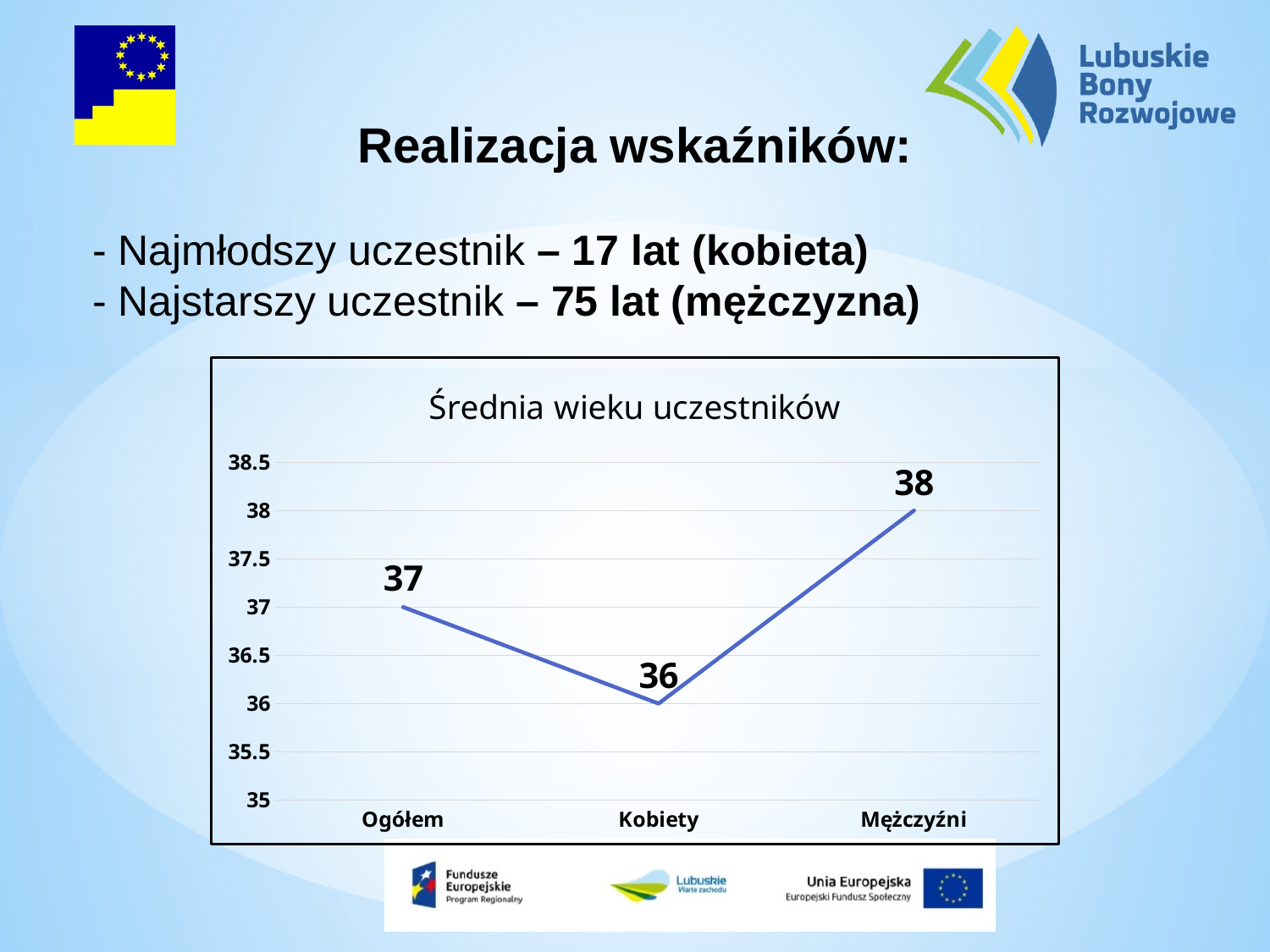
What is the highest value shown on the y axis? 38.5 Which category has the lowest average age? Kobiety What is the average age for Kobiety? 36 What is the difference between the average age of Mężczyźni and Kobiety? 2 What kind of chart is this? line chart Which category has the highest average age? Mężczyźni What is the title of the chart? Średnia wieku uczestników What is the average age for Ogółem? 37 Is the value for Mężczyźni greater or less than 37.5? greater What is the average age for Mężczyźni? 38 How many categories are shown on the x axis? 3 Which is larger, the average age for Ogółem or for Kobiety? Ogółem